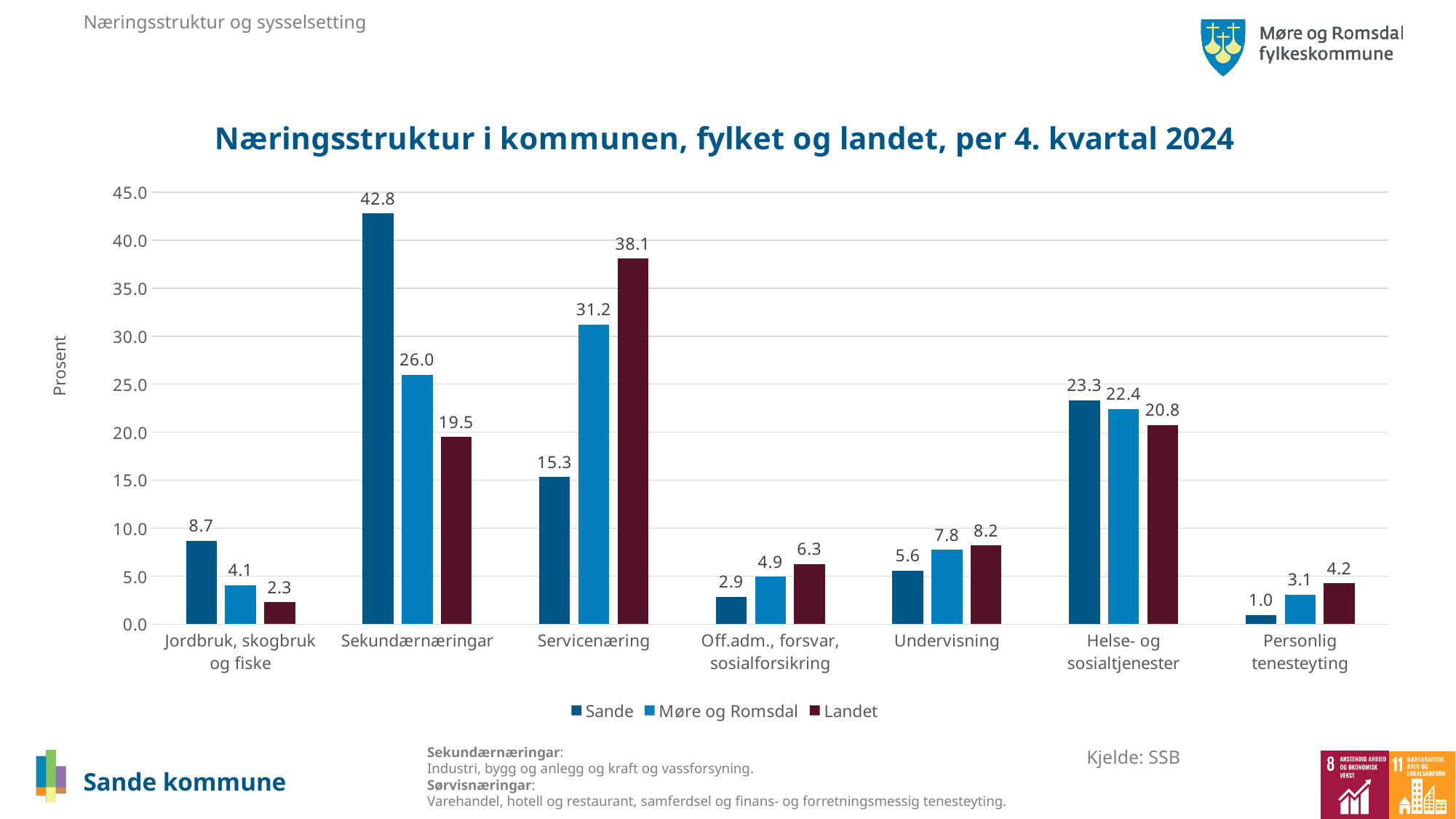
What is the value for Møre og Romsdal in Helse- og sosialtjenester? 22.4 What is the title of the chart? Næringsstruktur i kommunen, fylket og landet, per 4. kvartal 2024 How many categories are shown on the x axis? 7 What is the difference between the Sande and Landet values in Sekundærnæringar? 23.3 What is the value for Sande in Sekundærnæringar? 42.8 What is the value for Landet in Servicenæring? 38.1 Which category has the lowest value for Landet? Jordbruk, skogbruk og fiske Which is larger in Undervisning: the value for Sande or the value for Landet? Landet What kind of chart is shown on the slide? Bar chart Which category has the highest value for Sande? Sekundærnæringar What is the label on the y axis? Prosent How many series does the legend list? 3